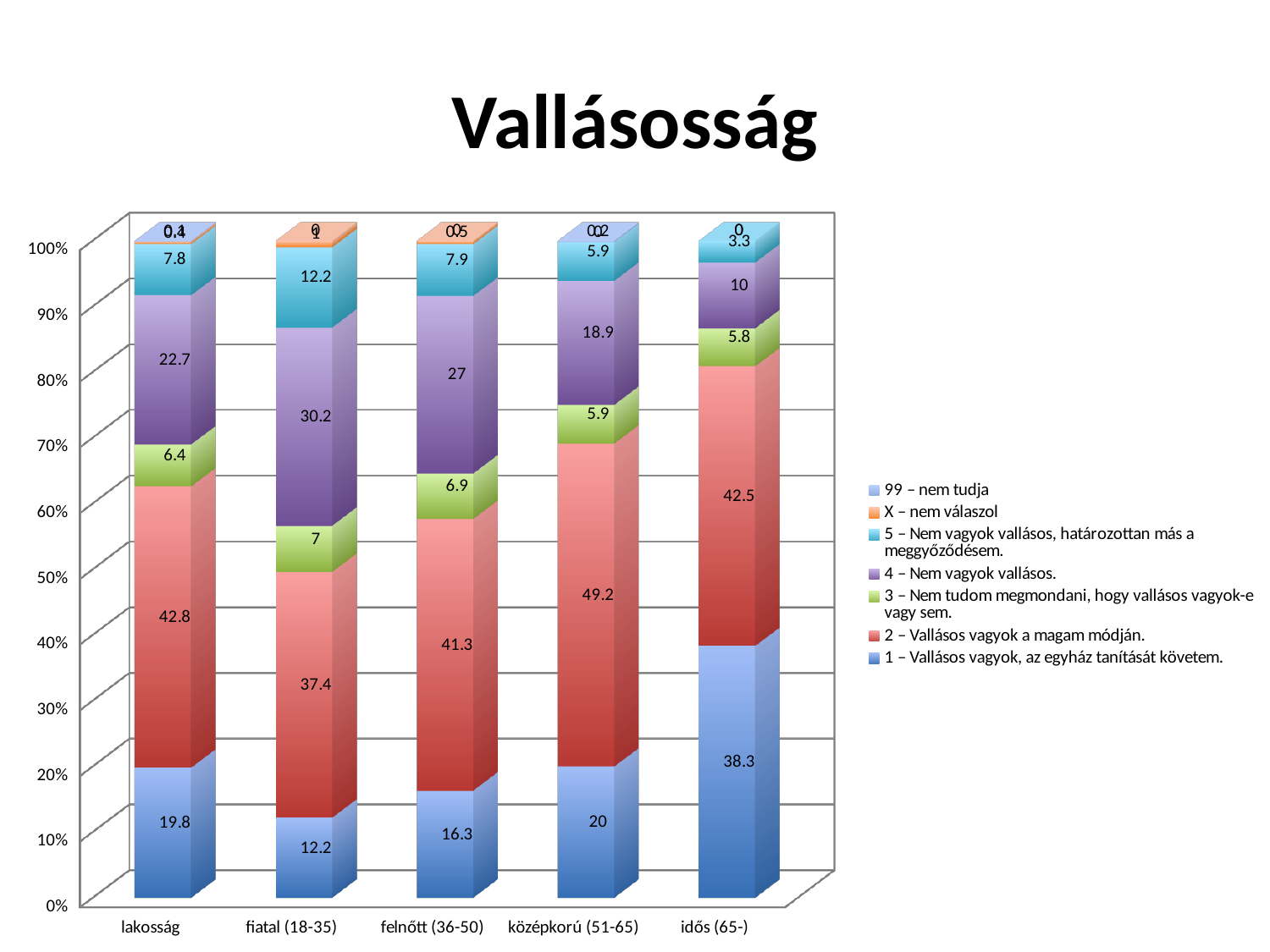
What is the value of series '2 – Vallásos vagyok a magam módján.' for 'középkorú (51-65)'? 49.2 What is the value of series '4 – Nem vagyok vallásos.' for 'felnőtt (36-50)'? 27 What is the title of the chart? Vallásosság Which category has the highest value for series '4 – Nem vagyok vallásos.'? fiatal (18-35) For series '5 – Nem vagyok vallásos, határozottan más a meggyőződésem.', which is larger: 'fiatal (18-35)' or 'felnőtt (36-50)'? fiatal (18-35) How many categories are shown along the x axis? 5 How many series does the legend list? 7 What is the difference between the values of series '1 – Vallásos vagyok, az egyház tanítását követem.' for 'idős (65-)' and 'lakosság'? 18.5 What kind of chart is shown on the slide? Stacked bar chart Which category has the highest value for series '1 – Vallásos vagyok, az egyház tanítását követem.'? idős (65-) What is the value of series '1 – Vallásos vagyok, az egyház tanítását követem.' for 'idős (65-)'? 38.3 Which category has the lowest value for series '1 – Vallásos vagyok, az egyház tanítását követem.'? fiatal (18-35)